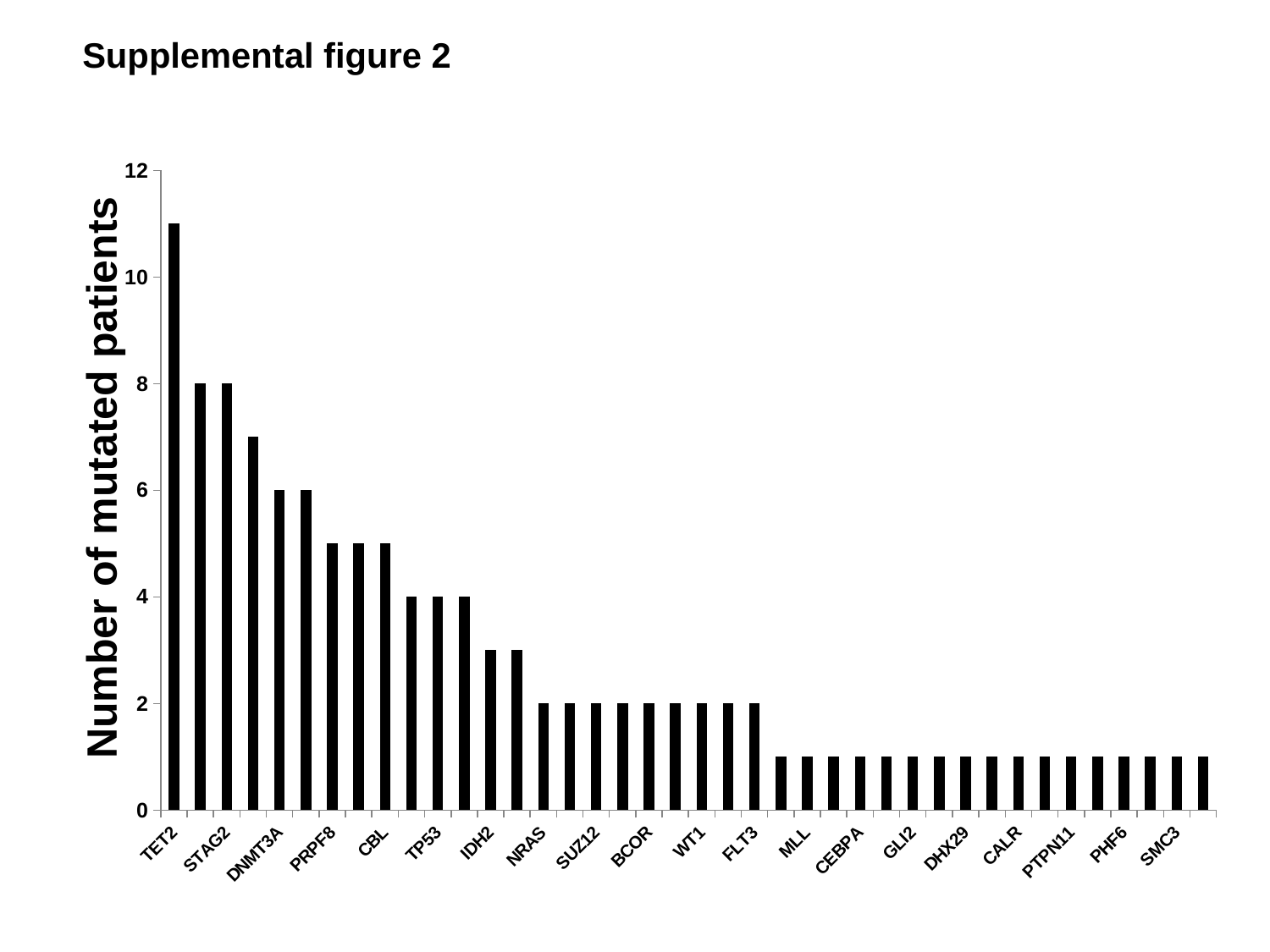
What is the number of mutated patients for TP53? 4 What is the number of mutated patients for FLT3? 2 What type of chart is shown on the slide? bar chart Which has more mutated patients, TET2 or CALR? TET2 Which gene has the highest number of mutated patients? TET2 What is the number of mutated patients for STAG2? 8 Do the bar values rise or fall from left to right along the x axis? fall Is the value for TET2 greater or less than 10? greater